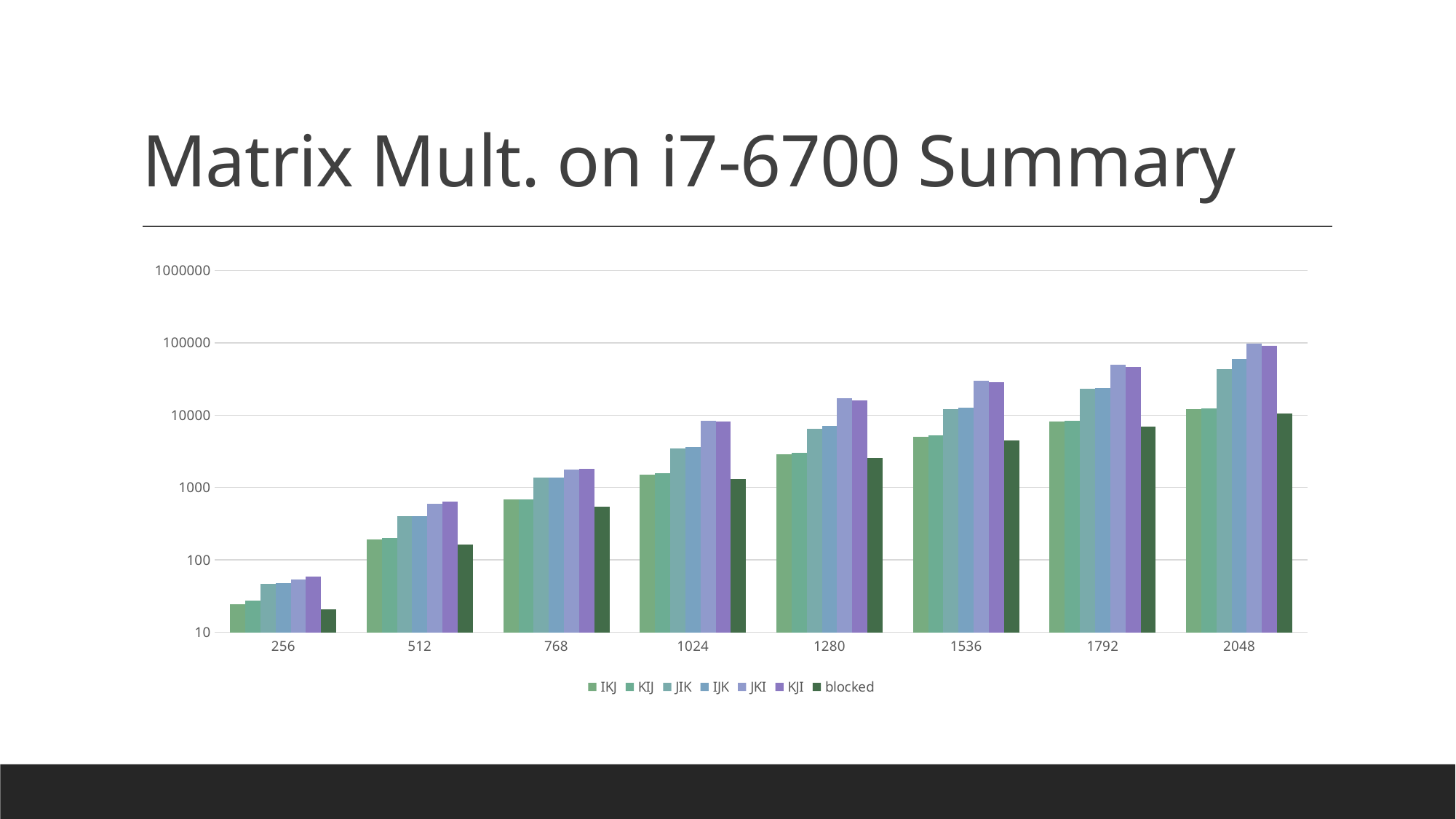
How many matrix-size categories are shown on the x axis? 8 Which series has the lowest value at matrix size 1024? blocked What is the title of the slide containing the chart? Matrix Mult. on i7-6700 Summary How many series does the legend list? 7 Is the value for JKI at 1536 greater or less than 10000? greater Is the value for blocked at 256 greater or less than 100? less What kind of chart is shown on the slide? bar chart Is the value for IKJ at 768 greater or less than 1000? less Which series has the lowest value at matrix size 256? blocked Do the values for IKJ rise or fall as the matrix size increases along the x axis? rise At matrix size 2048, which is larger, JKI or blocked? JKI